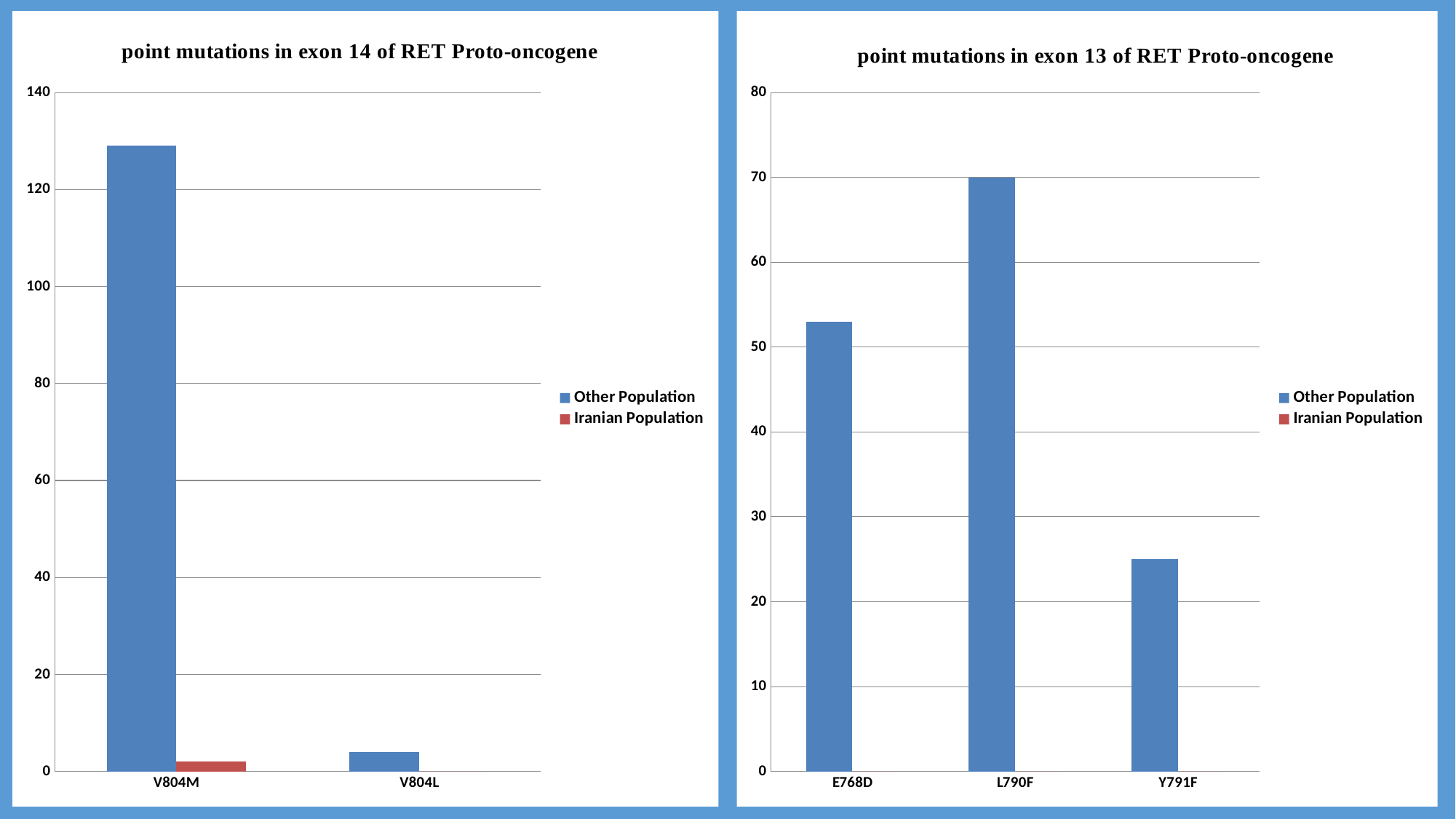
In the right chart, 'point mutations in exon 13 of RET Proto-oncogene', what is the Other Population value for L790F? 70 What kind of chart is the left chart, 'point mutations in exon 14 of RET Proto-oncogene'? bar chart In the left chart, 'point mutations in exon 14 of RET Proto-oncogene', how many mutation categories are shown on the x axis? 2 In the right chart, 'point mutations in exon 13 of RET Proto-oncogene', how many mutation categories are shown on the x axis? 3 In the left chart, 'point mutations in exon 14 of RET Proto-oncogene', how many series does the legend list? 2 In the right chart, 'point mutations in exon 13 of RET Proto-oncogene', is the value for E768D greater or less than 50? greater In the left chart, 'point mutations in exon 14 of RET Proto-oncogene', is the Other Population value for V804L greater or less than 20? less In the right chart, 'point mutations in exon 13 of RET Proto-oncogene', which mutation has the lowest value? Y791F In the left chart, 'point mutations in exon 14 of RET Proto-oncogene', is the Other Population value for V804M greater or less than 120? greater In the right chart, 'point mutations in exon 13 of RET Proto-oncogene', which mutation has the highest value? L790F In the left chart, 'point mutations in exon 14 of RET Proto-oncogene', which series has the larger value for V804M, Other Population or Iranian Population? Other Population In the left chart, 'point mutations in exon 14 of RET Proto-oncogene', which mutation has the highest Other Population value? V804M